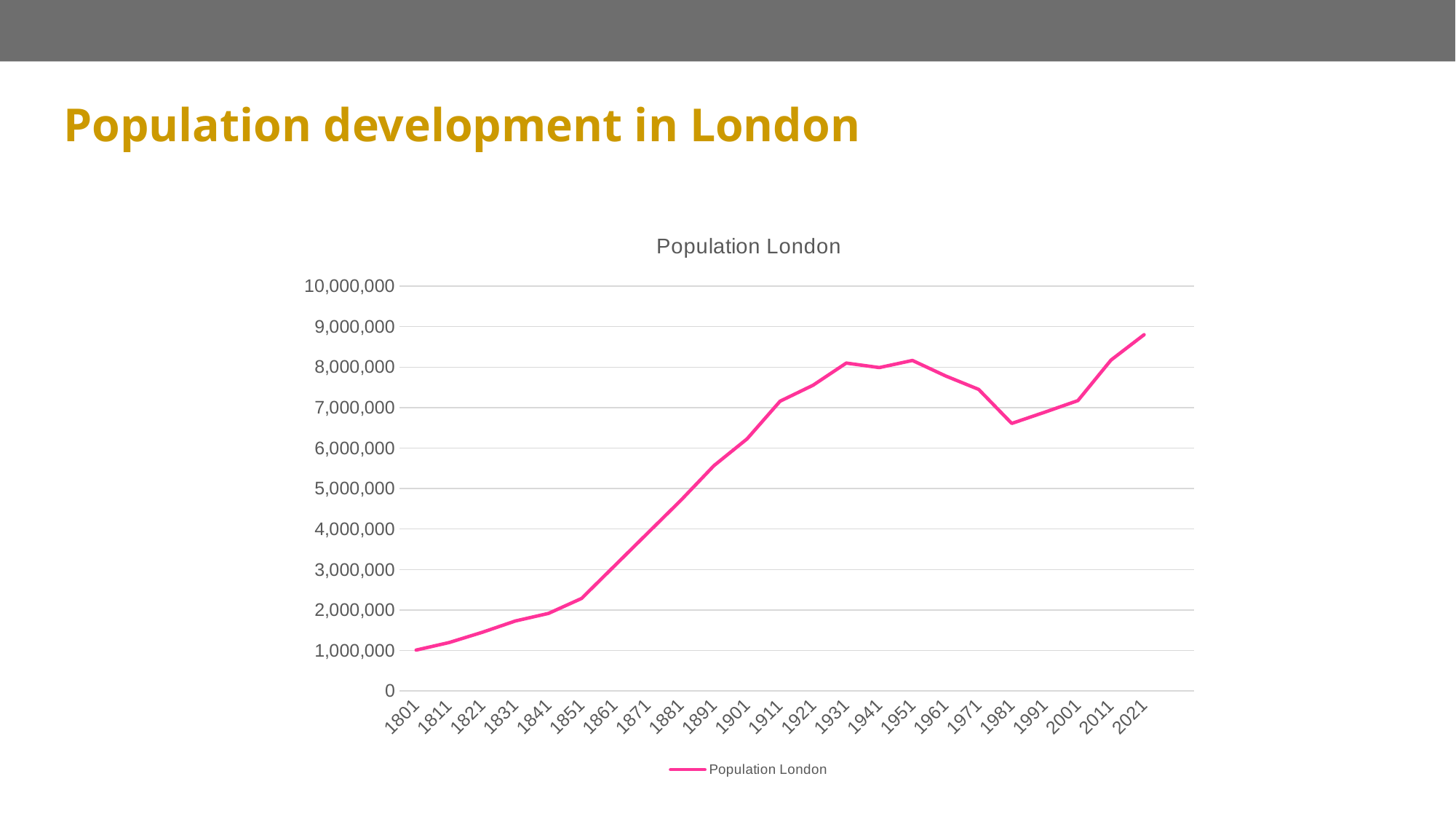
What is the title of the chart? Population London Is the value for 2021 greater or less than 8,000,000? greater Which year has the lowest population value? 1801 Is the value for 1891 greater or less than 5,000,000? greater How many years are plotted along the x axis? 23 What kind of chart is shown on the slide? line chart Which is larger, the value for 1951 or the value for 1981? 1951 Is the value for 1981 greater or less than 7,000,000? less How many series does the legend list? 1 Which year has the highest population value? 2021 Do the values rise or fall between 1951 and 1981? fall